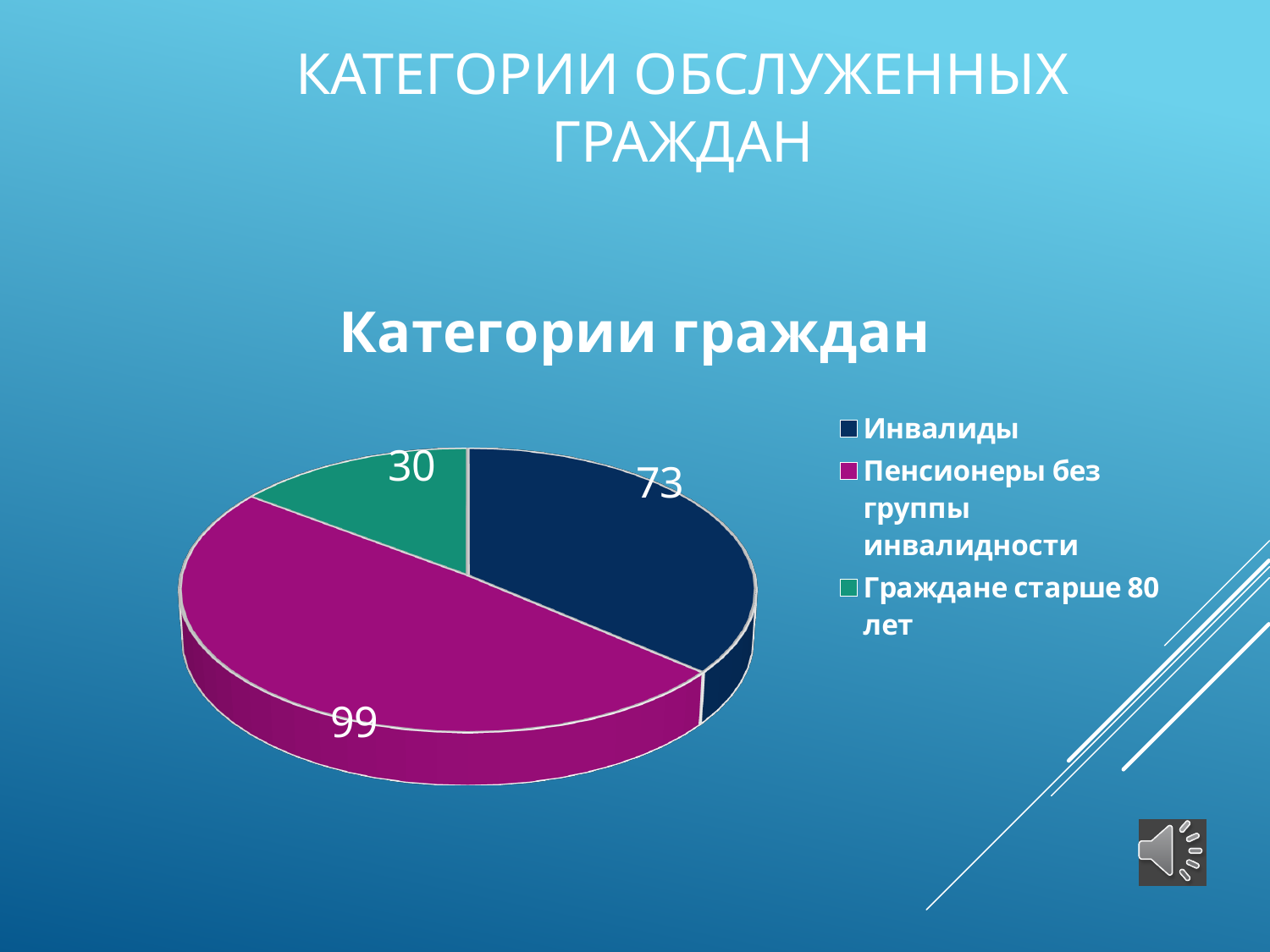
What is the total of all three slices? 202 Which category has the largest slice? Пенсионеры без группы инвалидности What is the difference between the values for Пенсионеры без группы инвалидности and Инвалиды? 26 What is the chart's title? Категории граждан Which category has the smallest slice? Граждане старше 80 лет How many slices does the pie chart have? 3 What is the value for Граждане старше 80 лет? 30 What is the value for Пенсионеры без группы инвалидности? 99 What is the value for Инвалиды? 73 Which is larger, the value for Инвалиды or the value for Граждане старше 80 лет? Инвалиды What kind of chart is shown on the slide? pie chart How many entries does the legend list? 3